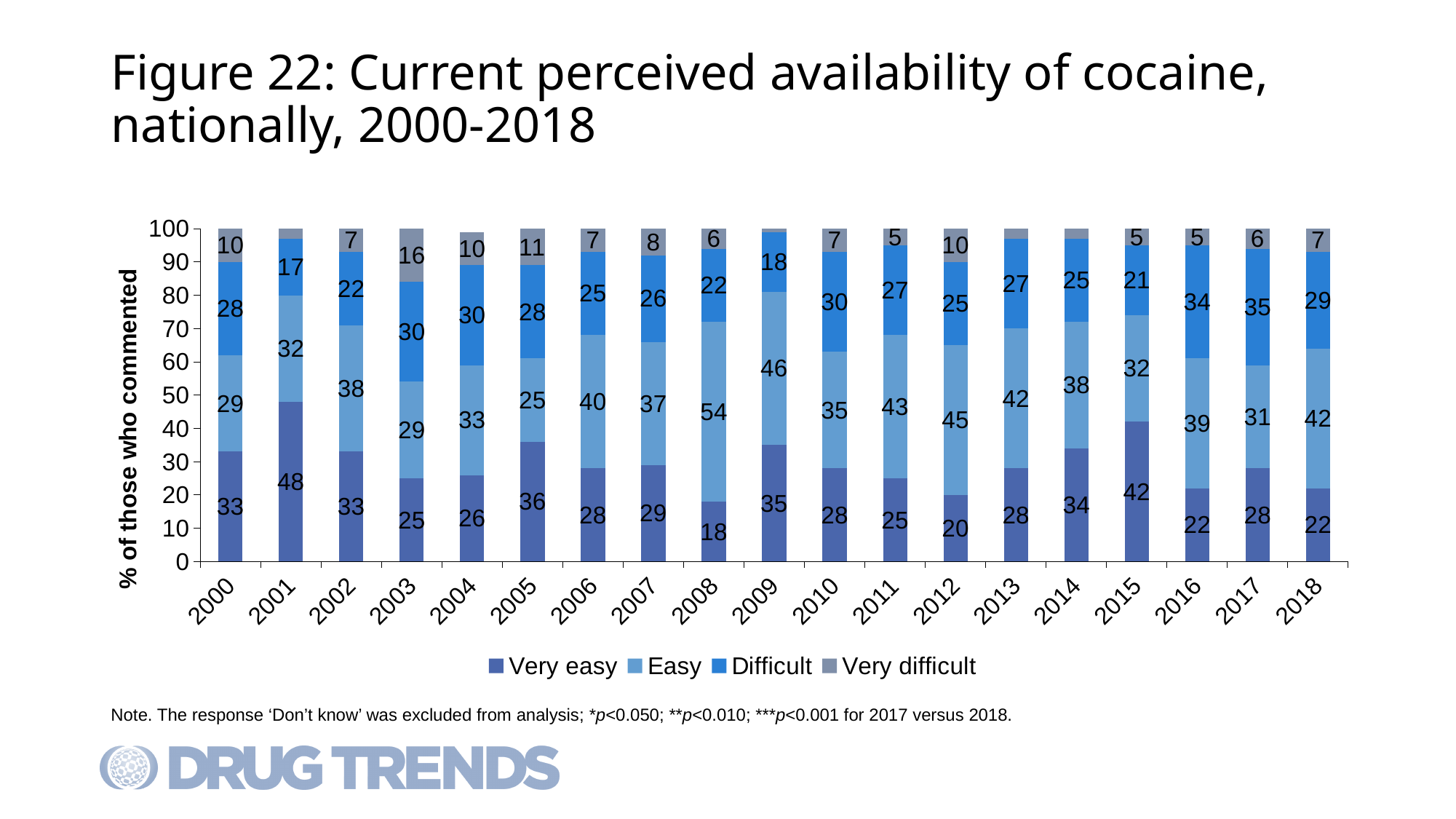
What is the 'Easy' value for 2008? 54 What is the 'Very difficult' value for 2003? 16 Which year has the highest 'Very easy' value? 2001 Which year has the lowest 'Very easy' value? 2008 What is the difference between the 'Very easy' values for 2017 and 2018? 6 Which year has the larger 'Easy' value, 2017 or 2018? 2018 How many years are shown on the x axis? 19 What is the 'Difficult' value for 2017? 35 How many series does the legend list? 4 Which year has the highest 'Very difficult' value? 2003 What kind of chart is shown on the slide? Stacked bar chart What percentage of respondents rated cocaine as 'Very easy' to obtain in 2001? 48